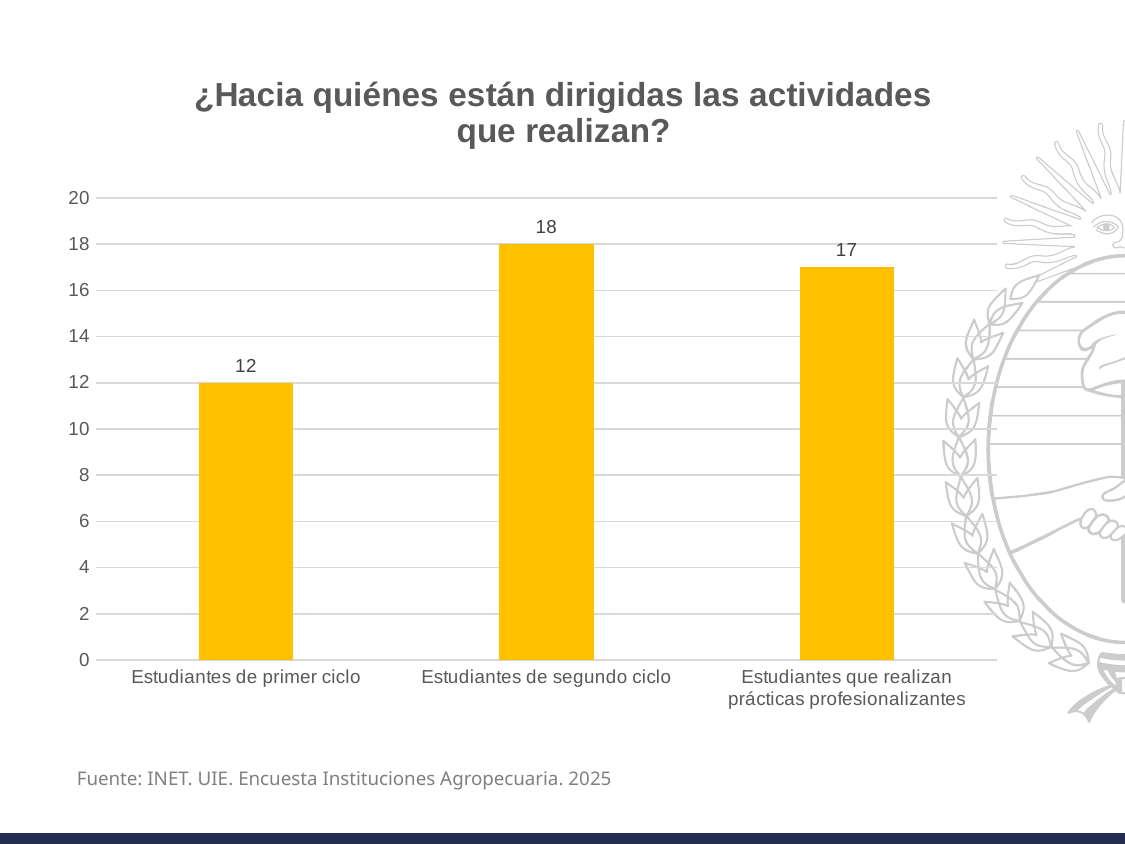
How many categories are shown on the x axis? 3 What is the difference between the values for Estudiantes de segundo ciclo and Estudiantes de primer ciclo? 6 What is the value for Estudiantes que realizan prácticas profesionalizantes? 17 Which category has the highest value? Estudiantes de segundo ciclo What is the title of the chart? ¿Hacia quiénes están dirigidas las actividades que realizan? Which is larger: the value for Estudiantes de primer ciclo or the value for Estudiantes que realizan prácticas profesionalizantes? Estudiantes que realizan prácticas profesionalizantes What is the value for Estudiantes de primer ciclo? 12 Which category has the lowest value? Estudiantes de primer ciclo What kind of chart is shown on the slide? bar chart Is the value for Estudiantes de primer ciclo greater or less than 14? less What is the difference between the values for Estudiantes de segundo ciclo and Estudiantes que realizan prácticas profesionalizantes? 1 What is the value for Estudiantes de segundo ciclo? 18